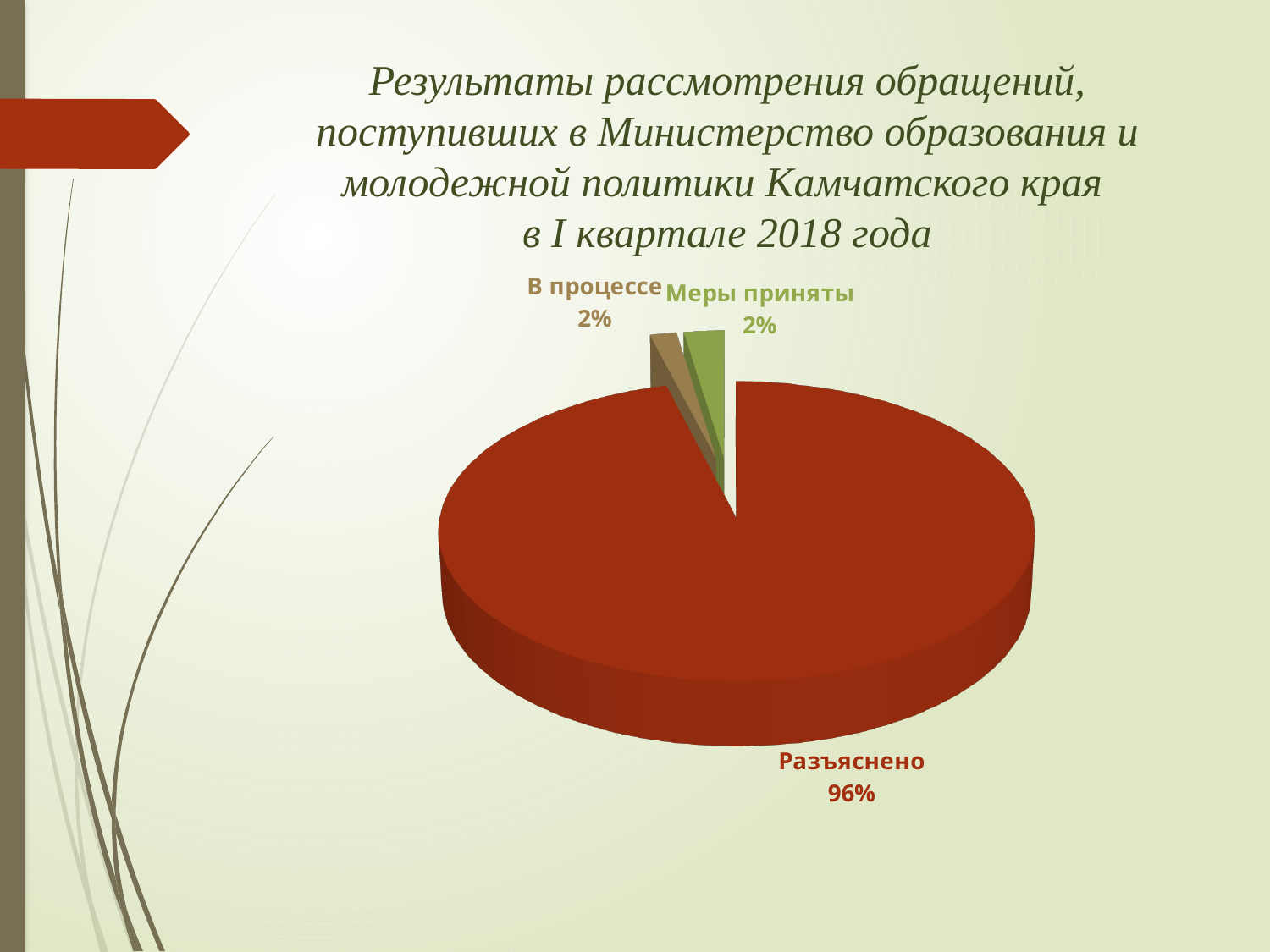
Is the share for "Разъяснено" greater or less than 50%? greater How many slices does the pie chart have? 3 What is the difference in percentage points between the "Разъяснено" slice and the "В процессе" slice? 94 What share of the pie does the "Меры приняты" slice represent? 2% Which category has the largest slice of the pie? Разъяснено What share of the pie does the "Разъяснено" slice represent? 96% What share of the pie does the "В процессе" slice represent? 2% Which is larger, the "Разъяснено" slice or the "Меры приняты" slice? Разъяснено What kind of chart is shown on the slide? Pie chart Which quarter and year does the chart title refer to? I квартал 2018 года What colour is the "Разъяснено" slice? Red